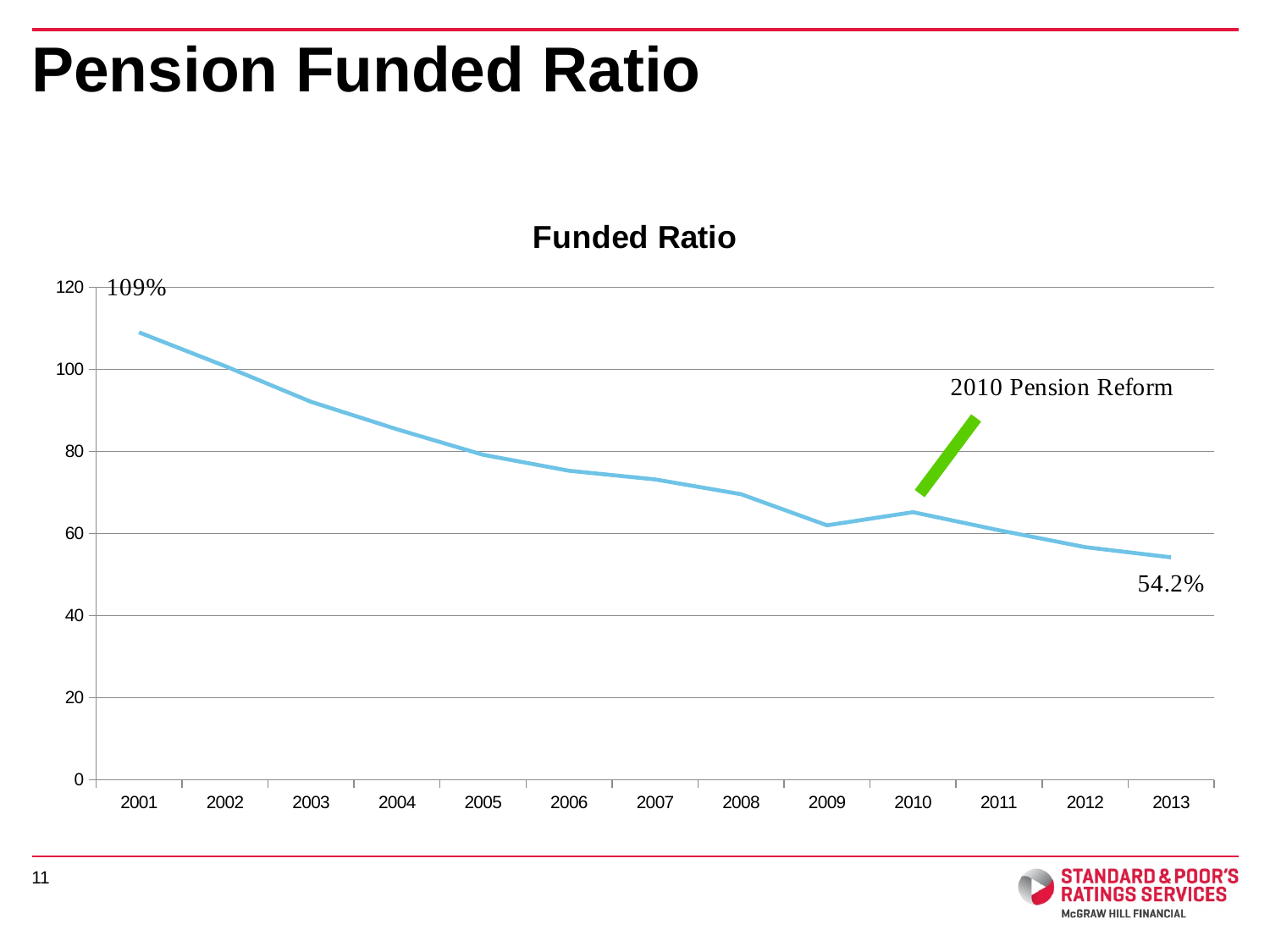
Which year has the larger funded ratio, 2009 or 2010? 2010 Is the value for 2005 greater or less than 100? less How many years are plotted along the x axis? 13 Is the value for 2003 greater or less than 80? greater What event does the green arrow annotation on the chart point to? 2010 Pension Reform Which year has the lowest funded ratio? 2013 What kind of chart is shown on the slide? line chart What is the title of the chart? Funded Ratio Which year has the highest funded ratio? 2001 Does the funded ratio generally rise or fall from 2001 to 2013? fall What is the funded ratio shown for 2001? 109% What is the funded ratio shown for 2013? 54.2%